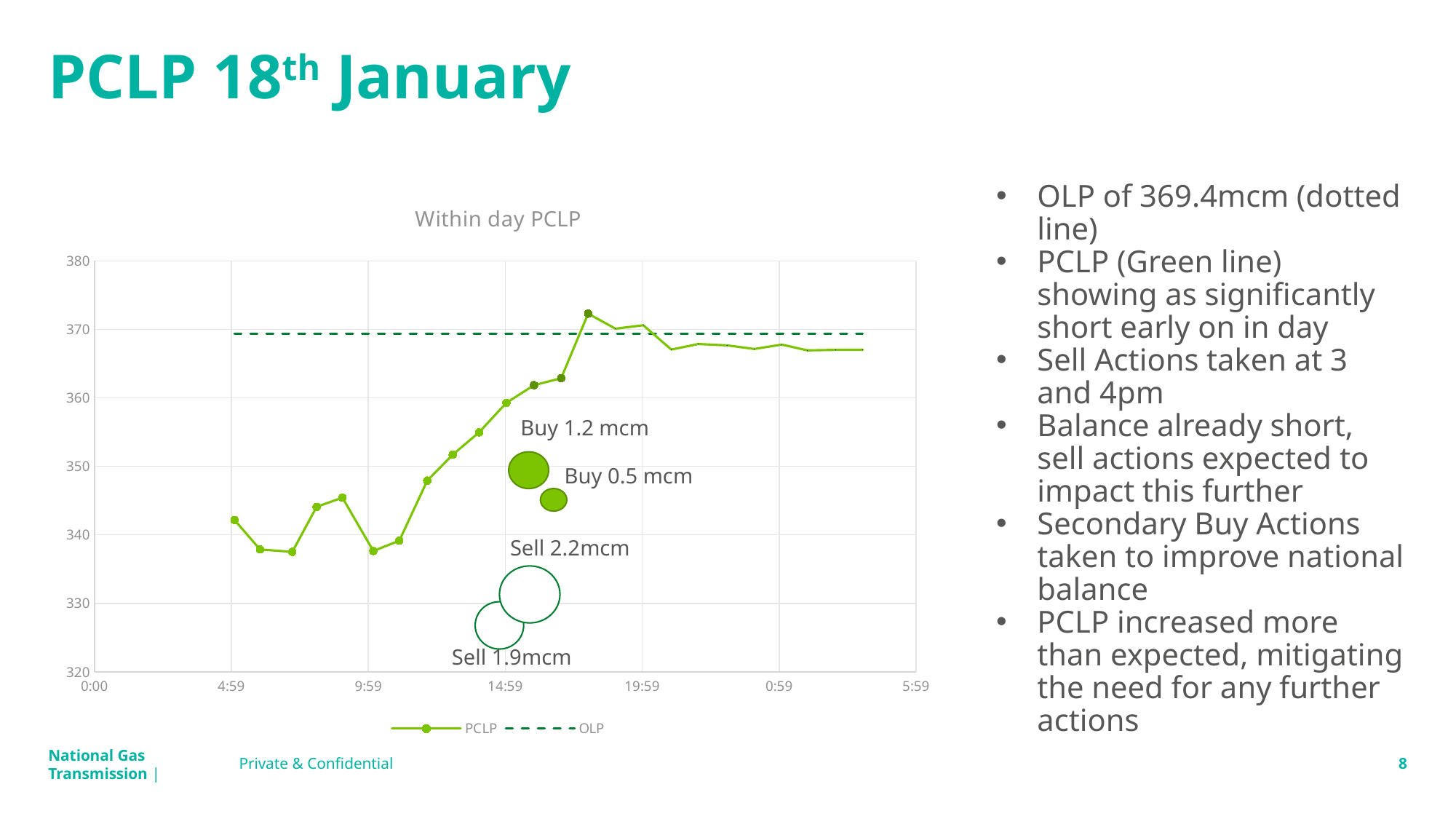
What is the size of the smallest buy action annotated on the chart? Buy 0.5 mcm What is the title of the chart? Within day PCLP What is the size of the largest sell action annotated on the chart? Sell 2.2mcm Is the PCLP value at 19:59 greater or less than 360? greater Does the PCLP line generally rise or fall between 9:59 and 19:59? rise Is the PCLP value at 4:59 greater or less than 350? less Is the OLP dotted line greater or less than 360? greater Which is larger: the PCLP value at 4:59 or the PCLP value at the last plotted point near 4:59 the next morning? the last plotted point What type of chart is shown on the slide? line chart Which series is drawn as a dotted line in the chart? OLP How many series does the chart legend list? 2